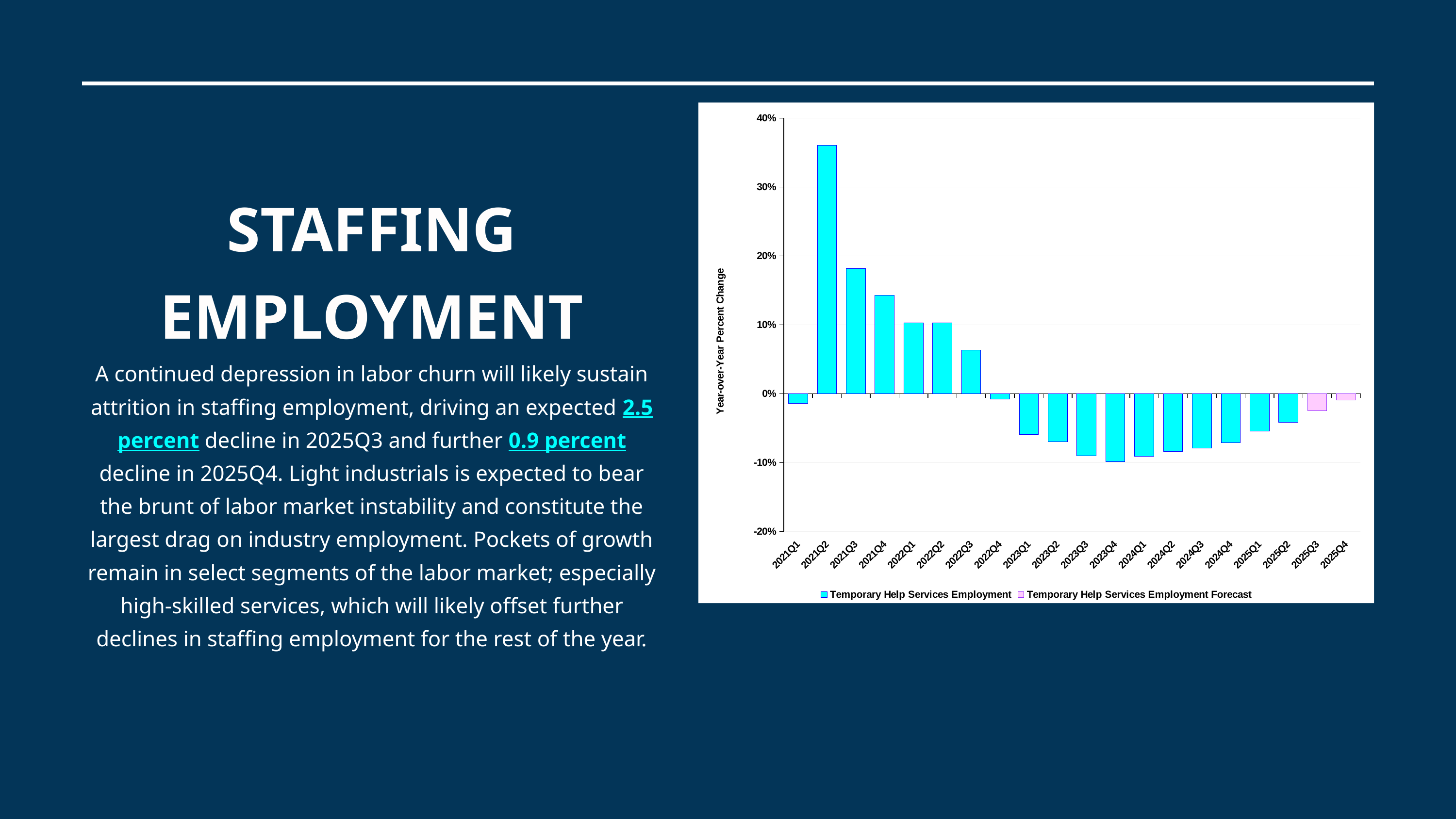
Is the value for 2021Q3 greater or less than 20%? less Is the value for 2023Q4 greater or less than -5%? less Which is larger, the value for 2021Q3 or the value for 2021Q4? 2021Q3 Which is larger, the value for 2023Q1 or the value for 2023Q3? 2023Q1 Is the value for 2021Q2 greater or less than 30%? greater What kind of chart is shown on the slide? Bar chart What is the title of the chart's vertical axis? Year-over-Year Percent Change Which quarter has the highest year-over-year percent change in the chart? 2021Q2 How many series does the chart's legend list? 2 How many quarters are shown on the x axis of the chart? 20 Do the values rise or fall from 2021Q2 to 2022Q4? Fall